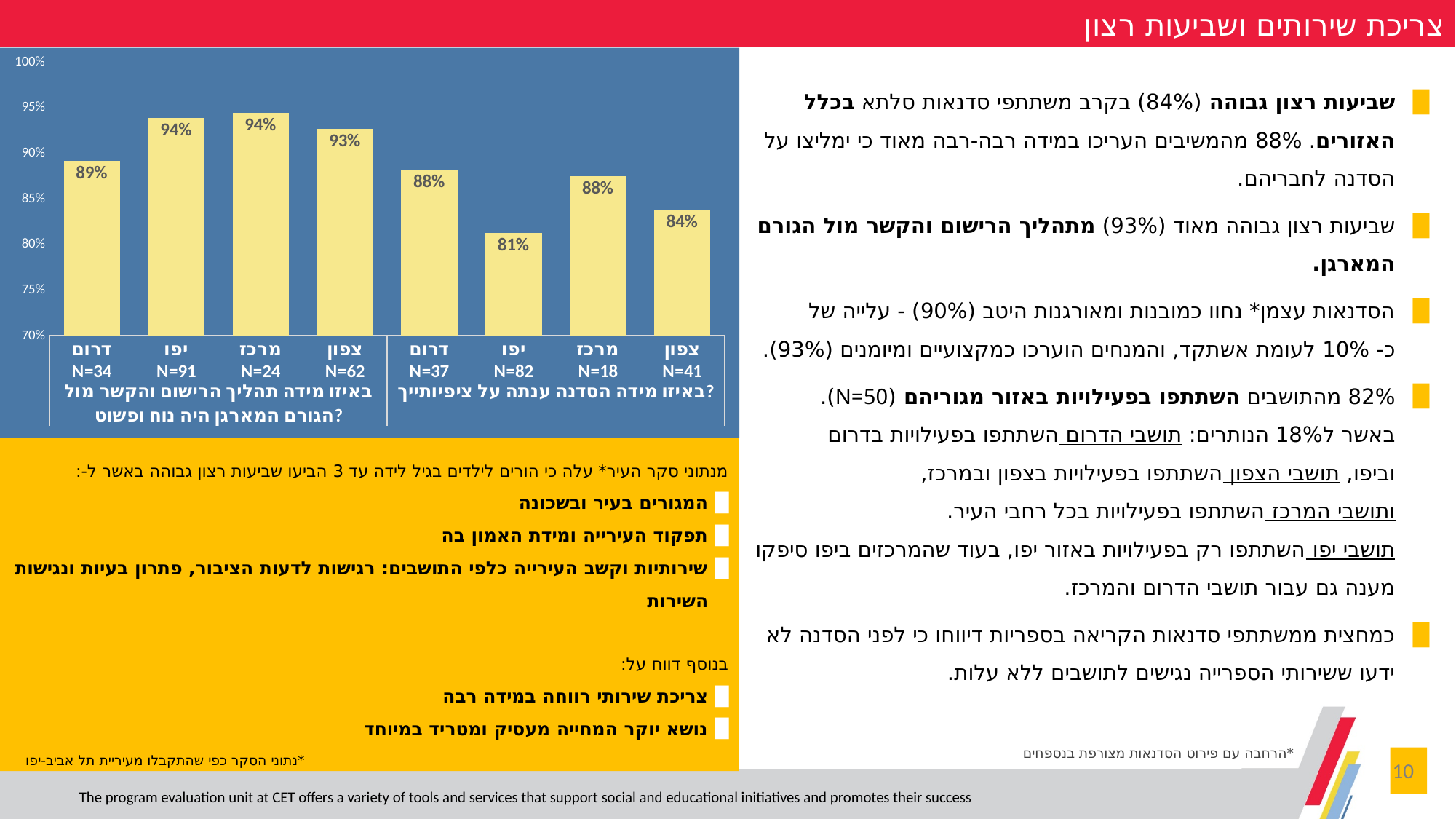
What is the difference between the value for צפון in the registration-process group (93%) and the value for צפון in the expectations group (84%)? 9% In the group 'באיזו מידה הסדנה ענתה על ציפיותייך?', what is the value for יפו (N=82)? 81% Which bar in the group 'באיזו מידה הסדנה ענתה על ציפיותייך?' has the lowest value? יפו (N=82) Which bar in the group 'באיזו מידה תהליך הרישום והקשר מול הגורם המארגן היה נוח ופשוט?' has the lowest value? דרום (N=34) What is the sample size (N) shown for מרכז in the group 'באיזו מידה הסדנה ענתה על ציפיותייך?'? N=18 In the group 'באיזו מידה תהליך הרישום והקשר מול הגורם המארגן היה נוח ופשוט?', what is the value for דרום (N=34)? 89% What kind of chart is shown on the slide? bar chart What is the lowest value shown on the y axis of the chart? 70% What is the difference between the value for דרום (N=37) and יפו (N=82) in the group 'באיזו מידה הסדנה ענתה על ציפיותייך?'? 7% Which is larger: the value for יפו in the registration-process group or the value for יפו in the expectations group? יפו in the registration-process group (94%) How many bars are plotted in the chart? 8 In the group 'באיזו מידה הסדנה ענתה על ציפיותייך?', what is the value for צפון (N=41)? 84%